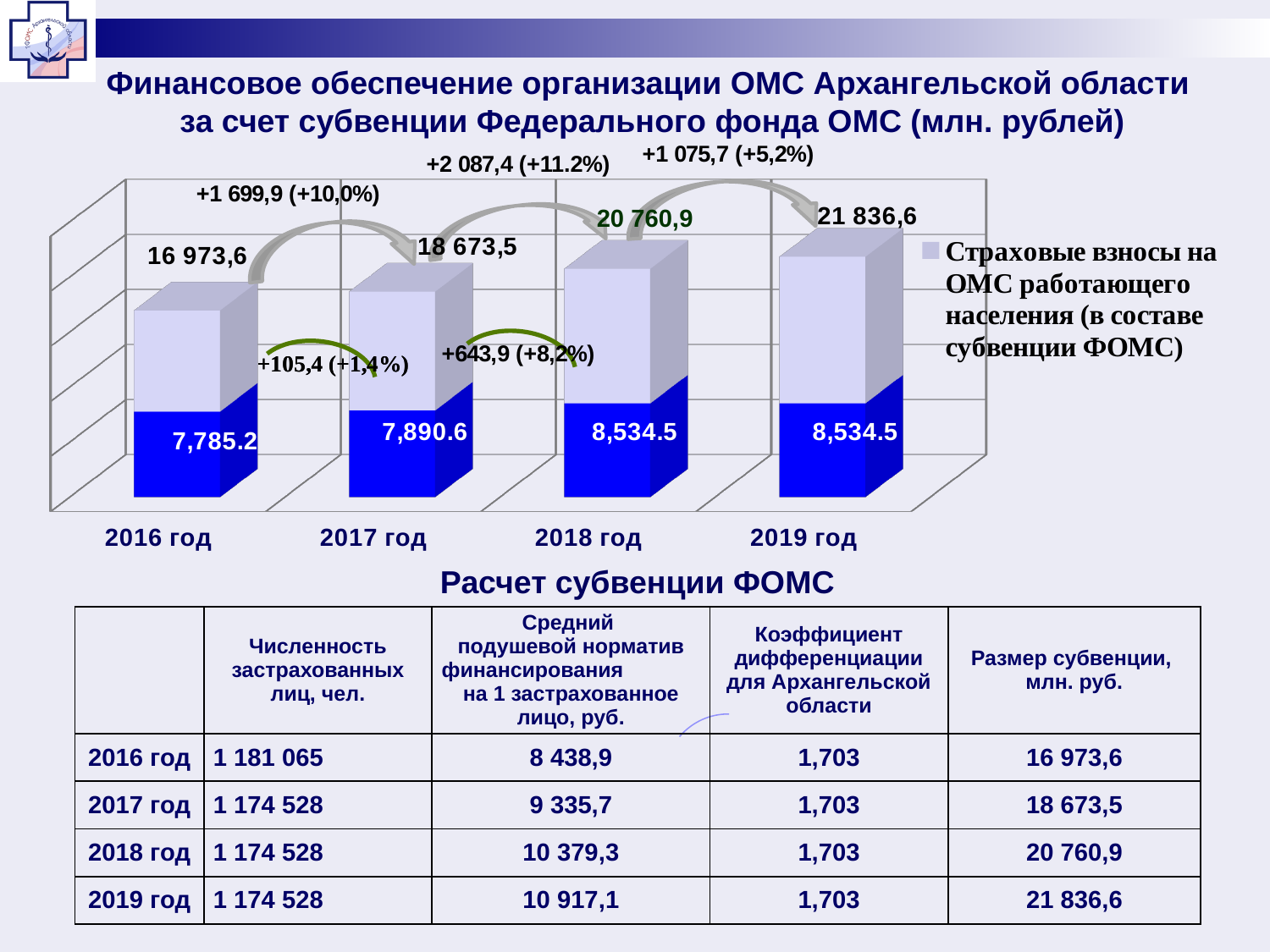
What series name is listed in the chart legend? Страховые взносы на ОМС работающего населения (в составе субвенции ФОМС) Which year has the highest total value in the chart? 2019 год Which year has the lowest total value in the chart? 2016 год How many years (categories) are shown on the x axis of the chart? 4 According to the annotation on the chart, by how much did the total increase from 2017 год to 2018 год? +2 087,4 (+11.2%) What is the total value labelled above the bar for 2016 год? 16 973,6 What is the total value labelled above the bar for 2019 год? 21 836,6 According to the annotation on the chart, by how much did the blue segment increase from 2016 год to 2017 год? +105,4 (+1,4%) Do the total values rise or fall from 2016 год to 2019 год? rise What type of chart is shown on the slide? bar chart